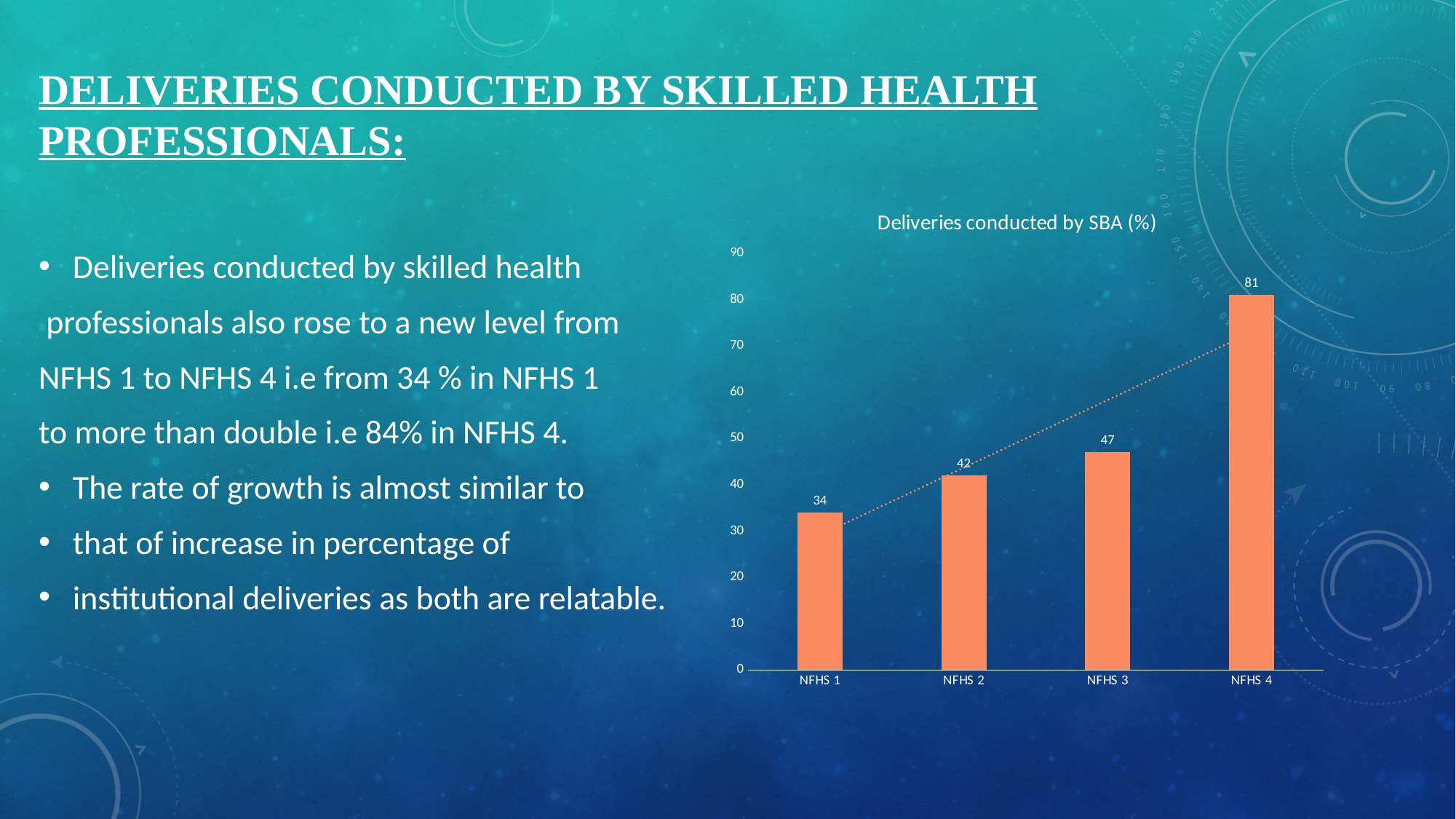
Which category has the lowest value in the chart? NFHS 1 Which category has the highest value in the chart? NFHS 4 Which is larger, the value for NFHS 2 or the value for NFHS 3? NFHS 3 What is the difference between the values for NFHS 3 and NFHS 2? 5 What is the value for NFHS 2 in the chart? 42 Do the values rise or fall from NFHS 1 to NFHS 4? Rise How many categories are shown on the x axis of the chart? 4 What is the value for NFHS 1 in the chart? 34 What is the value for NFHS 4 in the chart? 81 What kind of chart is shown on the slide? Bar chart What is the difference between the values for NFHS 4 and NFHS 1? 47 What is the value for NFHS 3 in the chart? 47